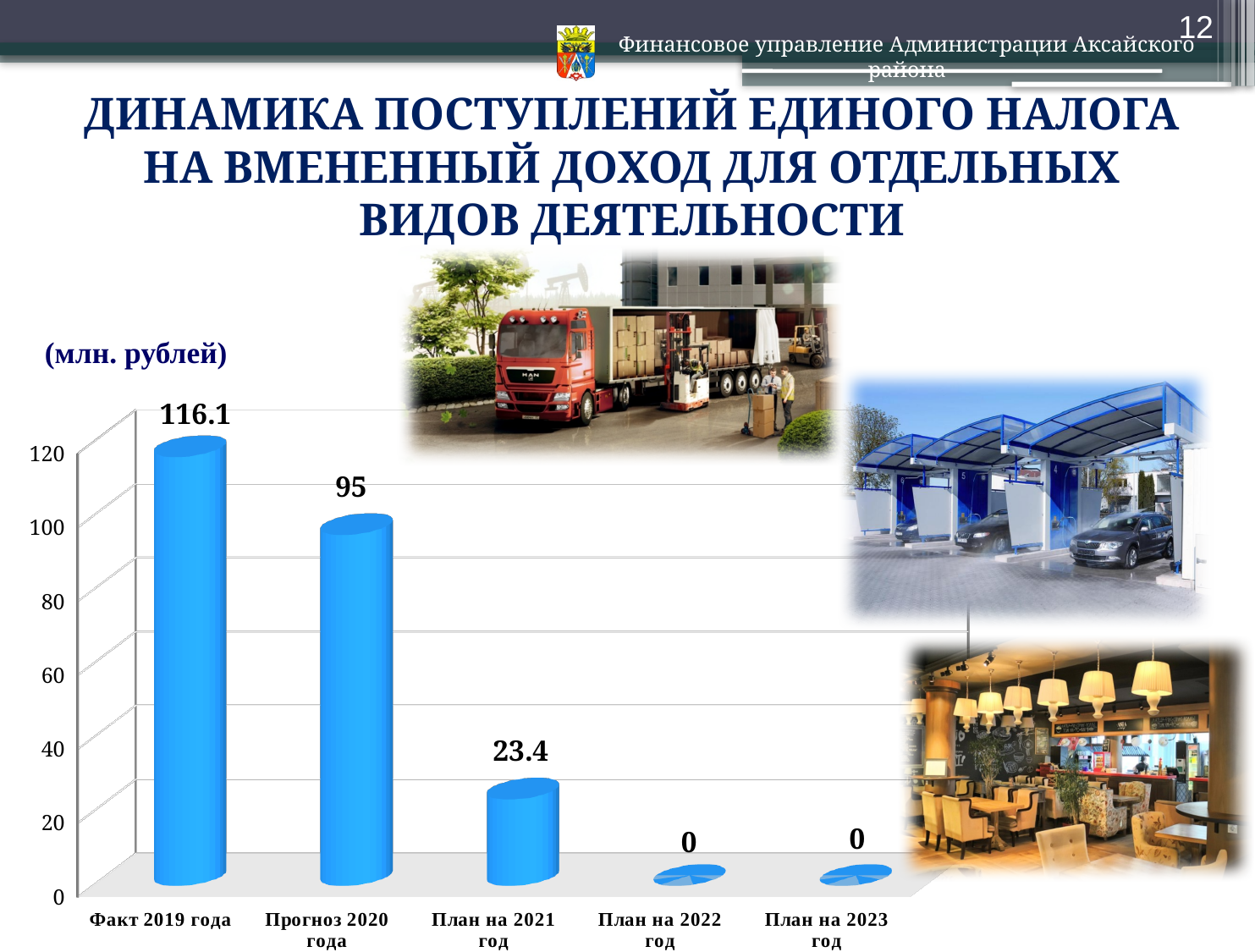
What is the value for План на 2023 год? 0 Is the value for Факт 2019 года greater or less than 100? greater What is the difference between the values for Прогноз 2020 года and План на 2021 год? 71.6 What is the value for Прогноз 2020 года? 95 What is the value for План на 2021 год? 23.4 Do the values rise or fall from Факт 2019 года to План на 2023 год? fall What is the value for Факт 2019 года? 116.1 Which category has the highest value? Факт 2019 года What is the difference between the values for Факт 2019 года and Прогноз 2020 года? 21.1 How many categories are shown on the x axis? 5 What kind of chart is shown on the slide? bar chart Which is larger, the value for Прогноз 2020 года or the value for План на 2021 год? Прогноз 2020 года